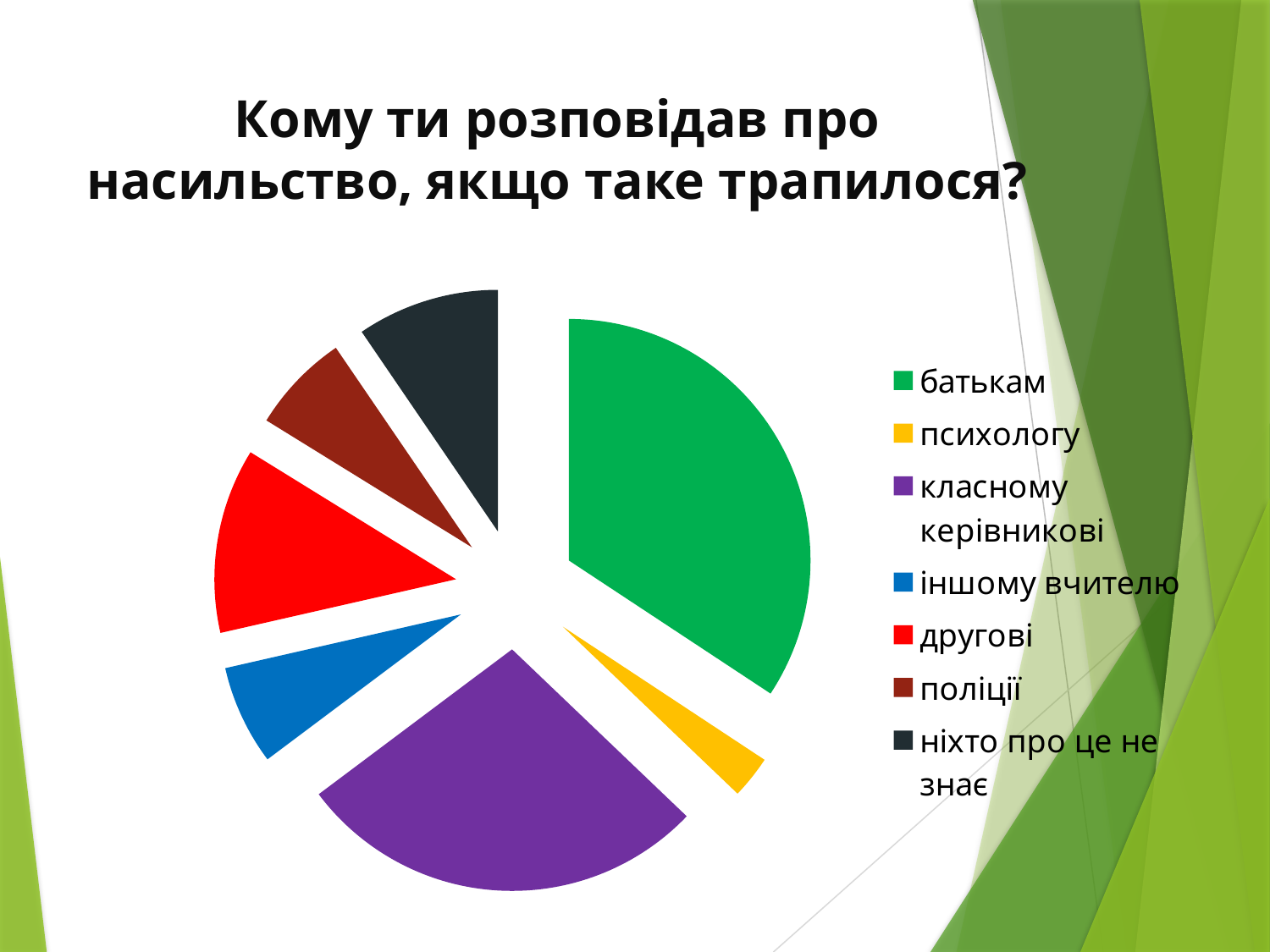
Which slice is larger: ніхто про це не знає or психологу? ніхто про це не знає Which category has the largest slice of the pie? батькам Which slice is larger: класному керівникові or поліції? класному керівникові What is the title of the chart on the slide? Кому ти розповідав про насильство, якщо таке трапилося? What colour is the slice for батькам? green Which slice is larger: другові or іншому вчителю? другові What kind of chart is shown on the slide? pie chart Which category has the smallest slice of the pie? психологу How many categories (slices) does the pie chart have? 7 Which category is the second largest slice of the pie? класному керівникові